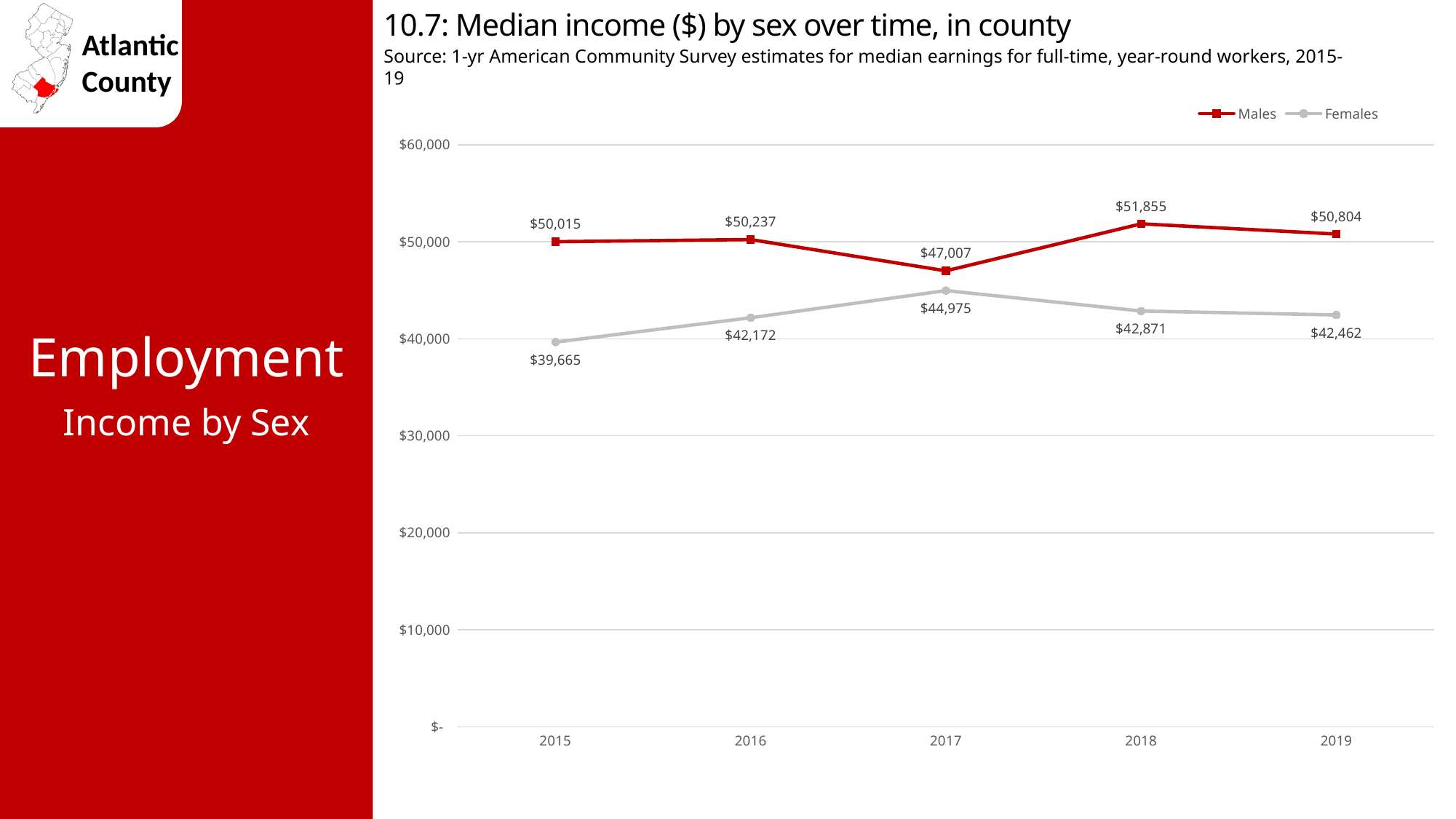
In which year was the median income for Females lowest? 2015 In which year was the median income for Males highest? 2018 How many years are shown on the x axis? 5 What was the median income for Males in 2017? $47,007 What was the median income for Females in 2015? $39,665 How many series does the legend list? 2 Which was larger in 2016, the median income for Males or for Females? Males What is the difference between the Males and Females median income in 2018? $8,984 What was the median income for Females in 2019? $42,462 Did the median income for Females rise or fall from 2015 to 2017? Rise Is the median income for Females in 2017 greater or less than $40,000? greater What kind of chart is shown on the slide? Line chart